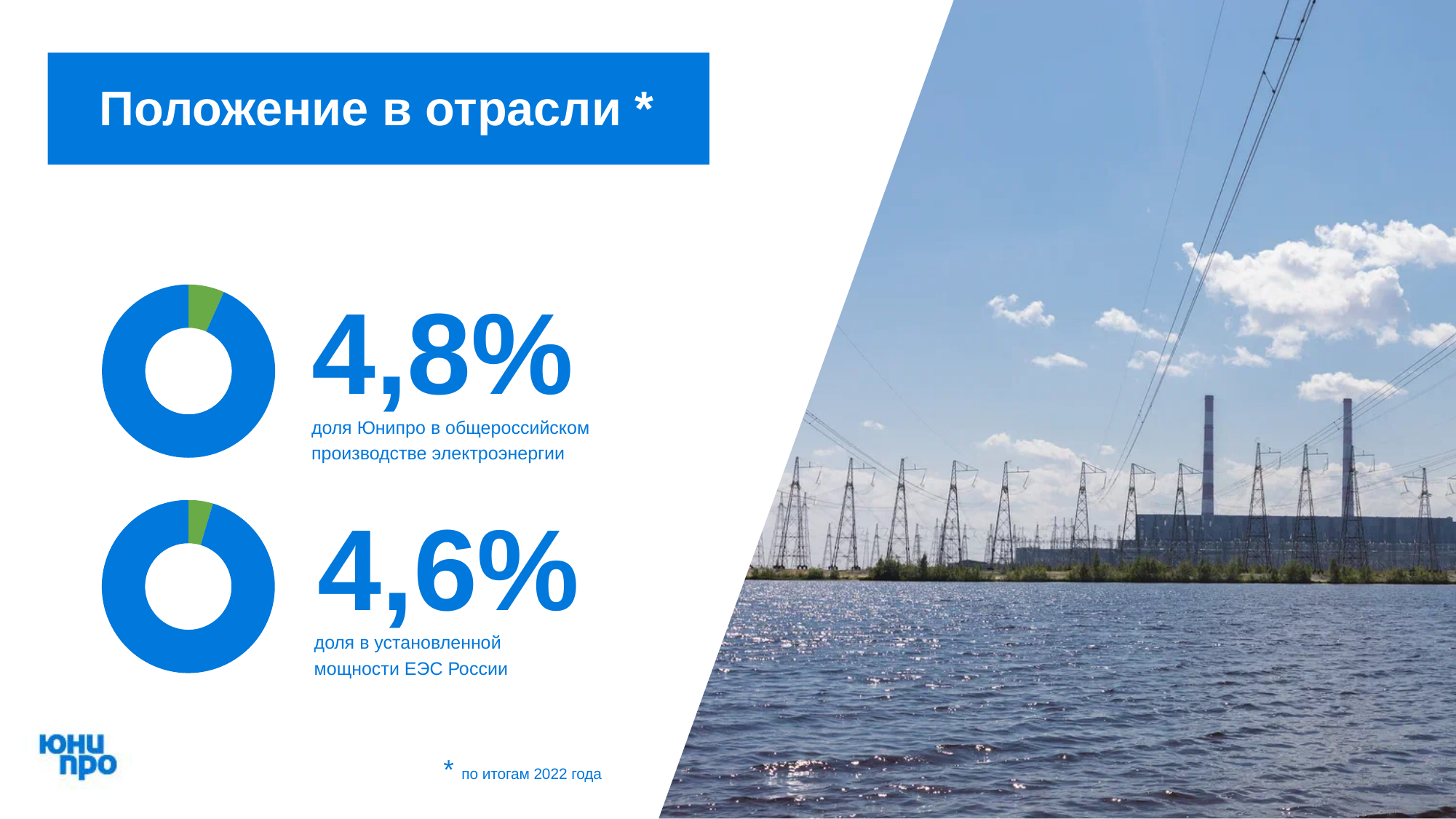
What is Unipro's share in total Russian electricity production, as shown next to the top donut chart? 4,8% By how many percentage points does the share in electricity production (4,8%) exceed the share in installed capacity (4,6%)? 0,2 Is the value shown for the top donut chart greater or less than 5%? less Which share is larger: the share in electricity production (top chart) or the share in installed capacity (bottom chart)? Share in electricity production (4,8%) What colour is the small slice representing Unipro's share in each donut chart? Green What kind of chart is used to show the 4,8% share on the slide? Donut (pie) chart According to the footnote, for which year are the shares in the donut charts given? 2022 What is the title of the slide containing the two donut charts? Положение в отрасли * How many donut charts are shown on the slide? 2 What is the share in the installed capacity of the UES of Russia, as shown next to the bottom donut chart? 4,6% Is the value shown for the bottom donut chart greater or less than 10%? less